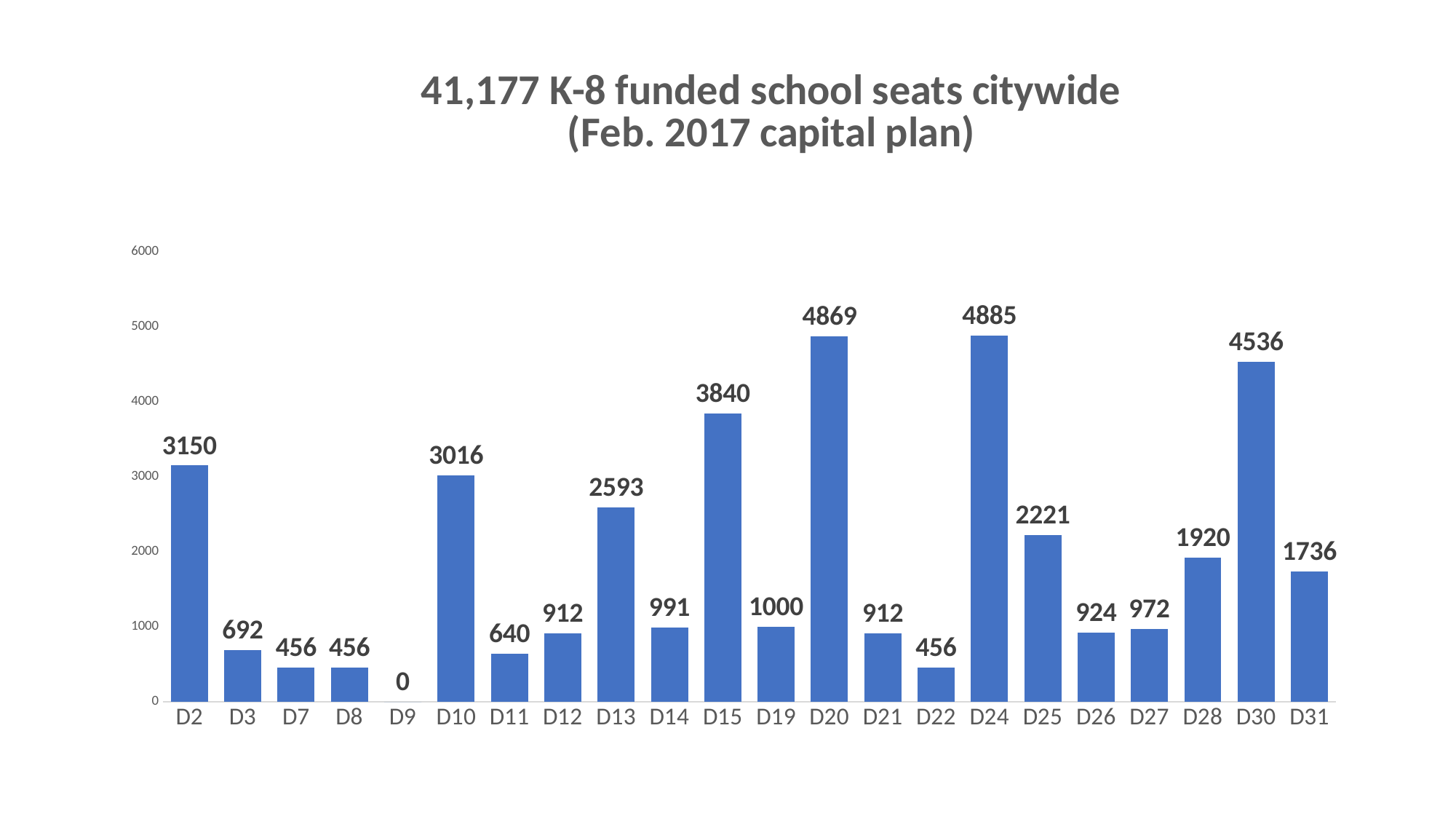
Which is larger, the value for D2 or the value for D10? D2 What is the title of the chart? 41,177 K-8 funded school seats citywide (Feb. 2017 capital plan) What is the value for D9? 0 How many districts are shown on the x axis? 22 What is the difference between the values for D24 and D20? 16 What is the value for D25? 2221 What is the difference between the values for D30 and D31? 2800 Which district has the lowest value? D9 Is the value for D28 greater or less than 2000? less What is the value for D15? 3840 Which district has the highest value? D24 What kind of chart is shown on the slide? bar chart